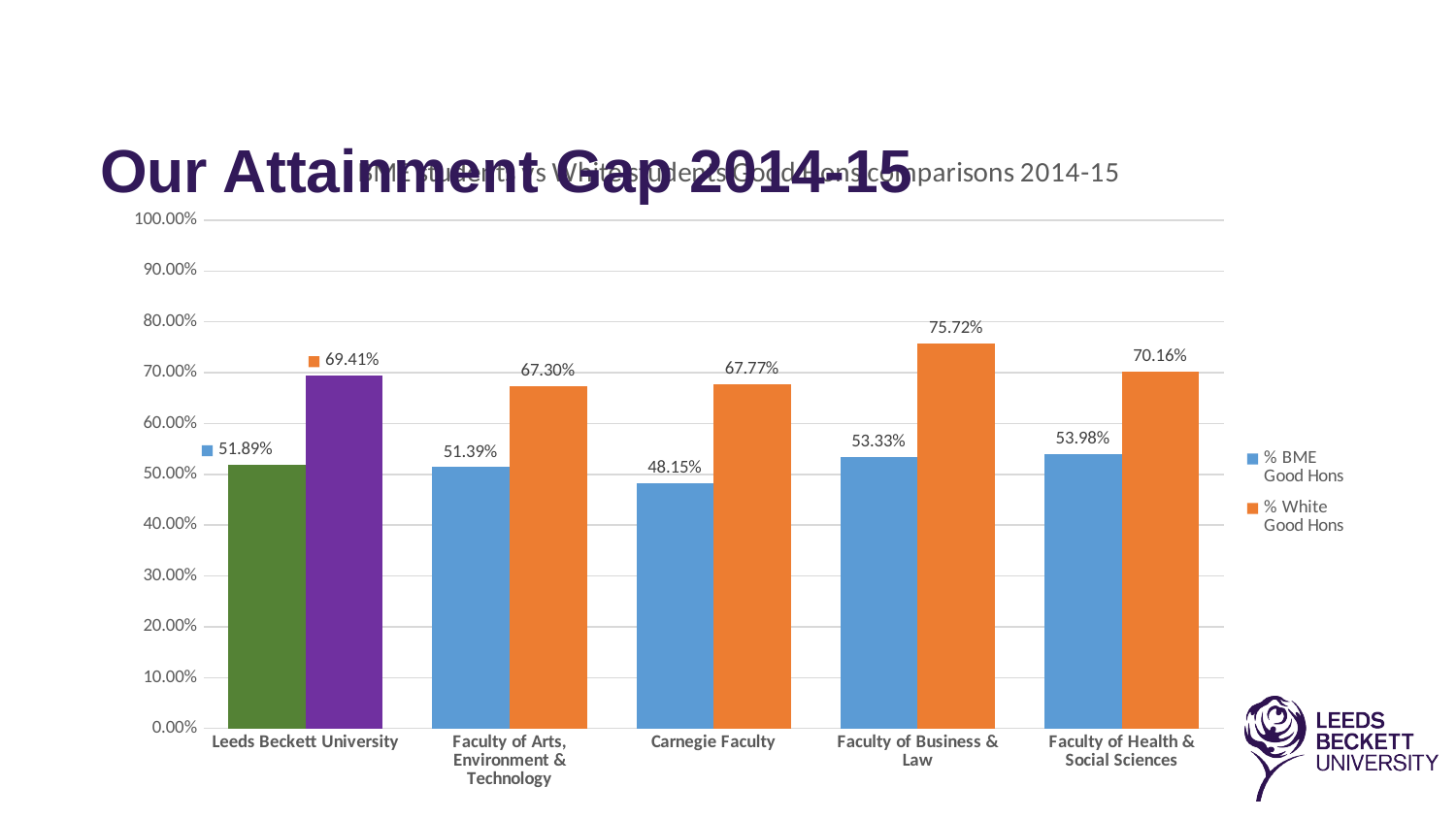
What is the % BME Good Hons value for Carnegie Faculty? 48.15% How many categories are shown on the x axis? 5 Which category has the lowest % BME Good Hons value? Carnegie Faculty What is the % BME Good Hons value for Leeds Beckett University? 51.89% Which category has the highest % White Good Hons value? Faculty of Business & Law What is the difference between the % White Good Hons and % BME Good Hons values for Faculty of Business & Law? 22.39% What is the % White Good Hons value for Faculty of Arts, Environment & Technology? 67.30% Is the % White Good Hons value for Leeds Beckett University greater or less than 60.00%? greater What kind of chart is shown on the slide? Bar chart What is the % White Good Hons value for Faculty of Business & Law? 75.72% How many series does the legend list? 2 Which is larger: the % BME Good Hons value for Faculty of Health & Social Sciences or for Faculty of Arts, Environment & Technology? Faculty of Health & Social Sciences